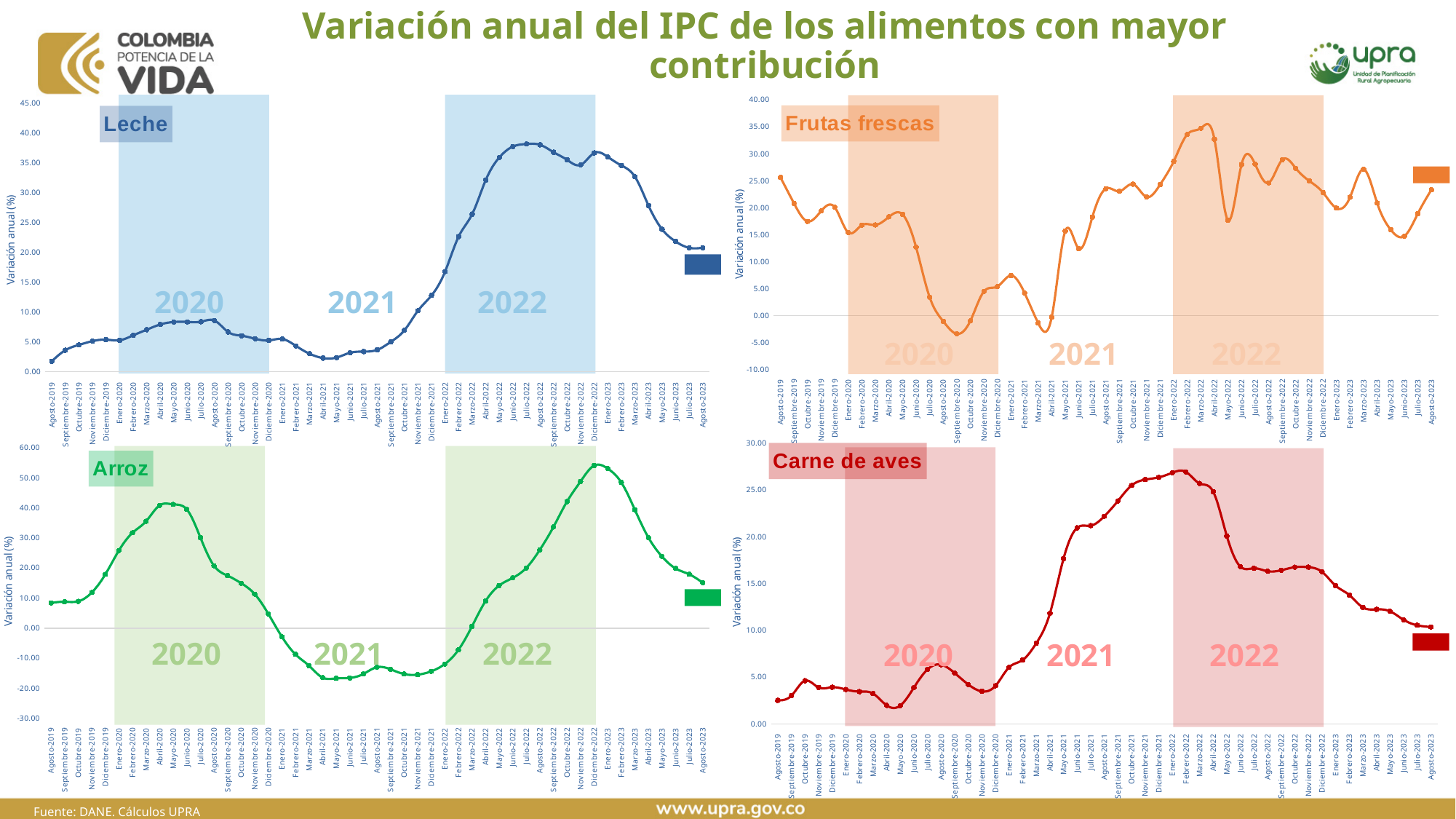
In the Leche chart, do the values rise or fall from Enero-2022 to Julio-2022? rise In the Frutas frescas chart, is the value for Agosto-2023 greater or less than 20? greater In the Carne de aves chart, do the values rise or fall from Enero-2022 to Agosto-2023? fall Which food is plotted in the green chart at the bottom left? Arroz In the Arroz chart, is the value for Abril-2021 greater or less than -10? less In the Frutas frescas chart, is the value for Septiembre-2020 greater or less than 0? less How many charts are shown on the slide? 4 What kind of chart is used for the Leche panel? line chart